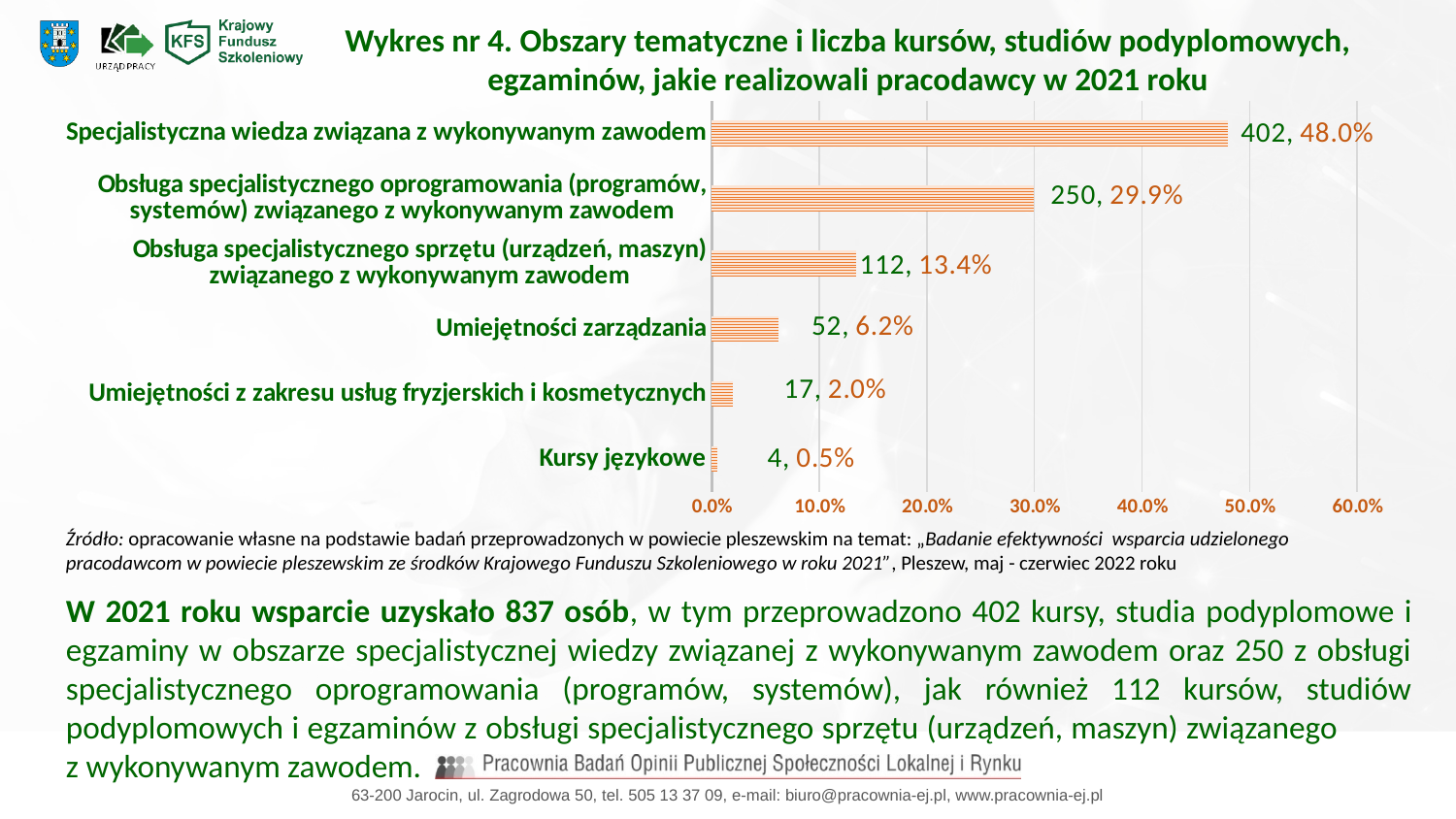
How many categories does the chart show? 6 Which category has the lowest value? Kursy językowe What is the number of courses for "Specjalistyczna wiedza związana z wykonywanym zawodem"? 402 What is the difference in the number of courses between "Specjalistyczna wiedza związana z wykonywanym zawodem" and "Obsługa specjalistycznego oprogramowania (programów, systemów) związanego z wykonywanym zawodem"? 152 What is the number of courses for "Kursy językowe"? 4 What percentage is shown for "Umiejętności zarządzania"? 6.2% What is the title of the chart? Wykres nr 4. Obszary tematyczne i liczba kursów, studiów podyplomowych, egzaminów, jakie realizowali pracodawcy w 2021 roku Is the percentage for "Obsługa specjalistycznego oprogramowania (programów, systemów) związanego z wykonywanym zawodem" greater or less than 20.0%? greater Which category has the highest value? Specjalistyczna wiedza związana z wykonywanym zawodem Which has a larger value: "Umiejętności zarządzania" or "Umiejętności z zakresu usług fryzjerskich i kosmetycznych"? Umiejętności zarządzania What kind of chart is shown on the slide? bar chart What percentage is shown for "Obsługa specjalistycznego sprzętu (urządzeń, maszyn) związanego z wykonywanym zawodem"? 13.4%